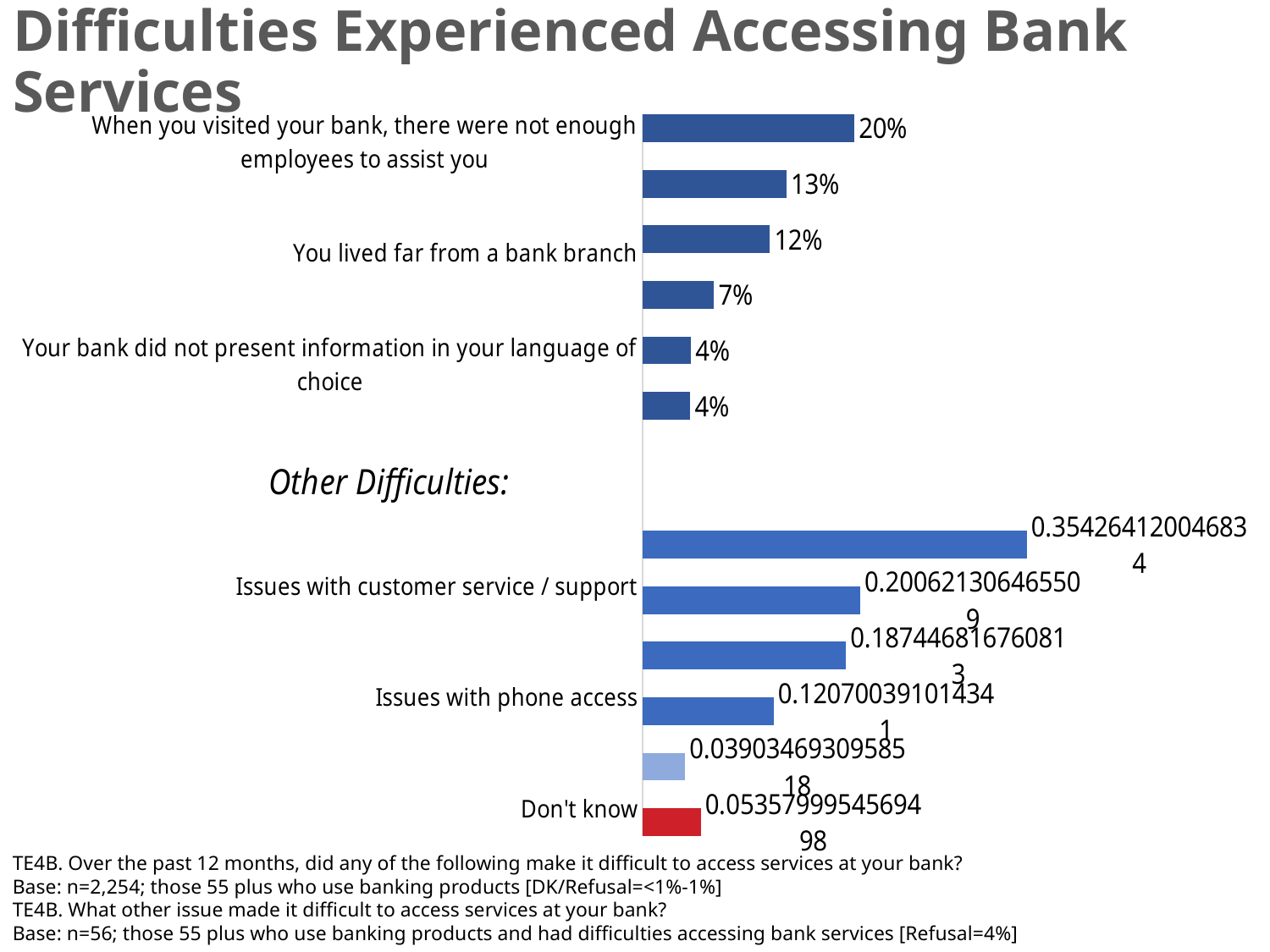
What colour is the bar for 'Don't know'? Red What kind of chart is shown on the slide? Bar chart What percentage is shown for 'Your bank did not present information in your language of choice'? 4% How many bars are plotted on the chart in total? 12 Which has a larger value: 'Issues with customer service / support' or 'Issues with phone access'? Issues with customer service / support What is the difference between the value for 'not enough employees to assist you' and the value for 'Your bank did not present information in your language of choice'? 16 percentage points What percentage is shown for 'When you visited your bank, there were not enough employees to assist you'? 20% What percentage is shown for 'You lived far from a bank branch'? 12% What is the difference between the value for 'not enough employees to assist you' and the value for 'You lived far from a bank branch'? 8 percentage points Which has a larger value: 'You lived far from a bank branch' or 'Your bank did not present information in your language of choice'? You lived far from a bank branch Among the bars labelled with percentages, which category has the highest value? When you visited your bank, there were not enough employees to assist you How many bars are labelled 4%? 2